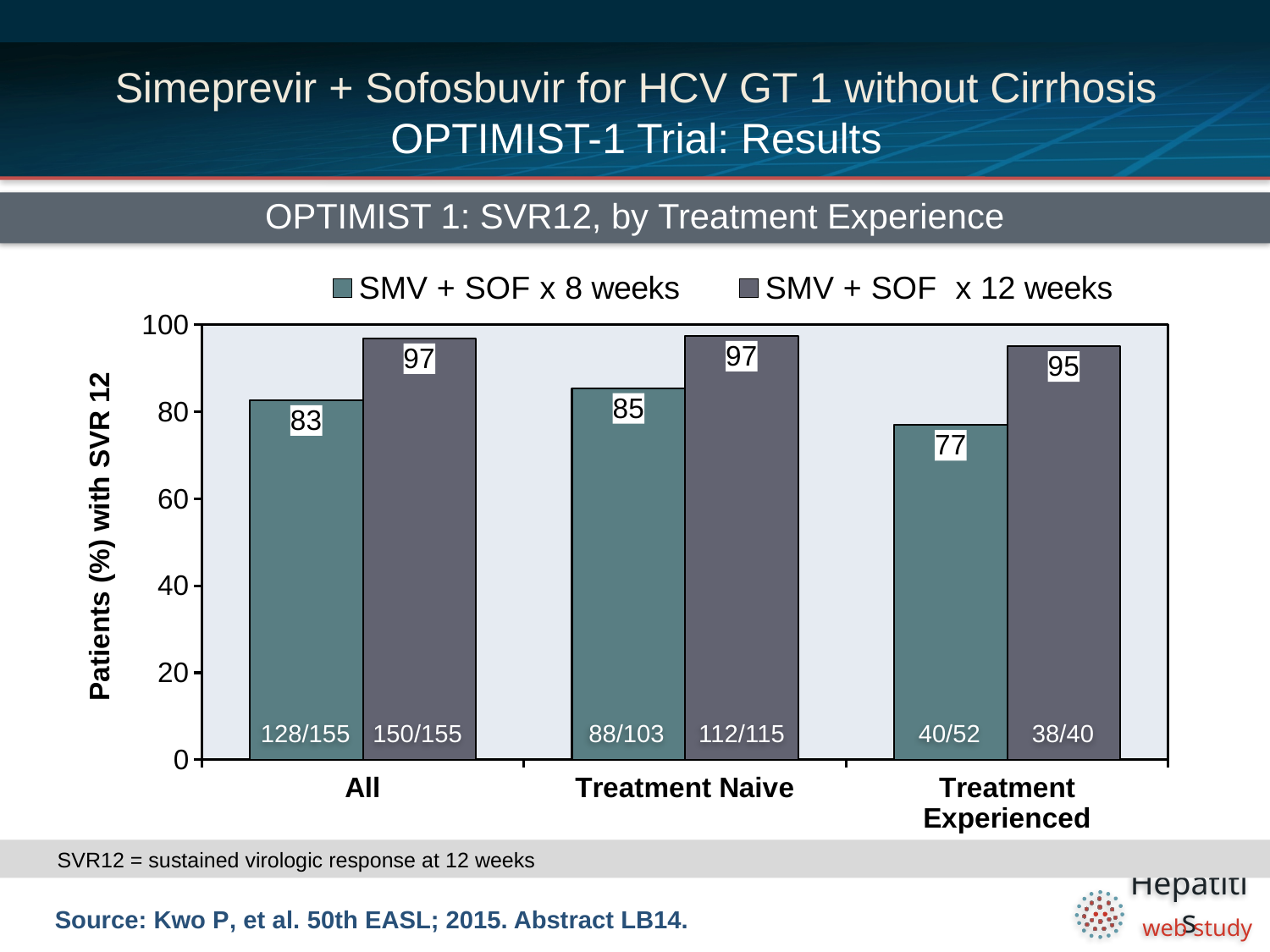
What is the difference between the 12-week and 8-week SVR12 rates in the Treatment Experienced category? 18 What fraction of patients is shown inside the SMV + SOF x 12 weeks bar for the All category? 150/155 What is the difference between the 12-week and 8-week SVR12 rates in the All category? 14 How many series does the legend list? 2 Which category has the lowest SVR12 rate for the SMV + SOF x 8 weeks group? Treatment Experienced What is the SVR12 rate for the SMV + SOF x 12 weeks group in the Treatment Experienced category? 95 Which is larger in the Treatment Naive category: the SVR12 rate for 8 weeks or for 12 weeks? 12 weeks What is the SVR12 rate for the SMV + SOF x 8 weeks group in the All category? 83 How many treatment experience categories are shown on the x axis? 3 What kind of chart is shown on the slide? Bar chart What is the label of the y axis? Patients (%) with SVR 12 What is the SVR12 rate for the SMV + SOF x 8 weeks group among Treatment Naive patients? 85